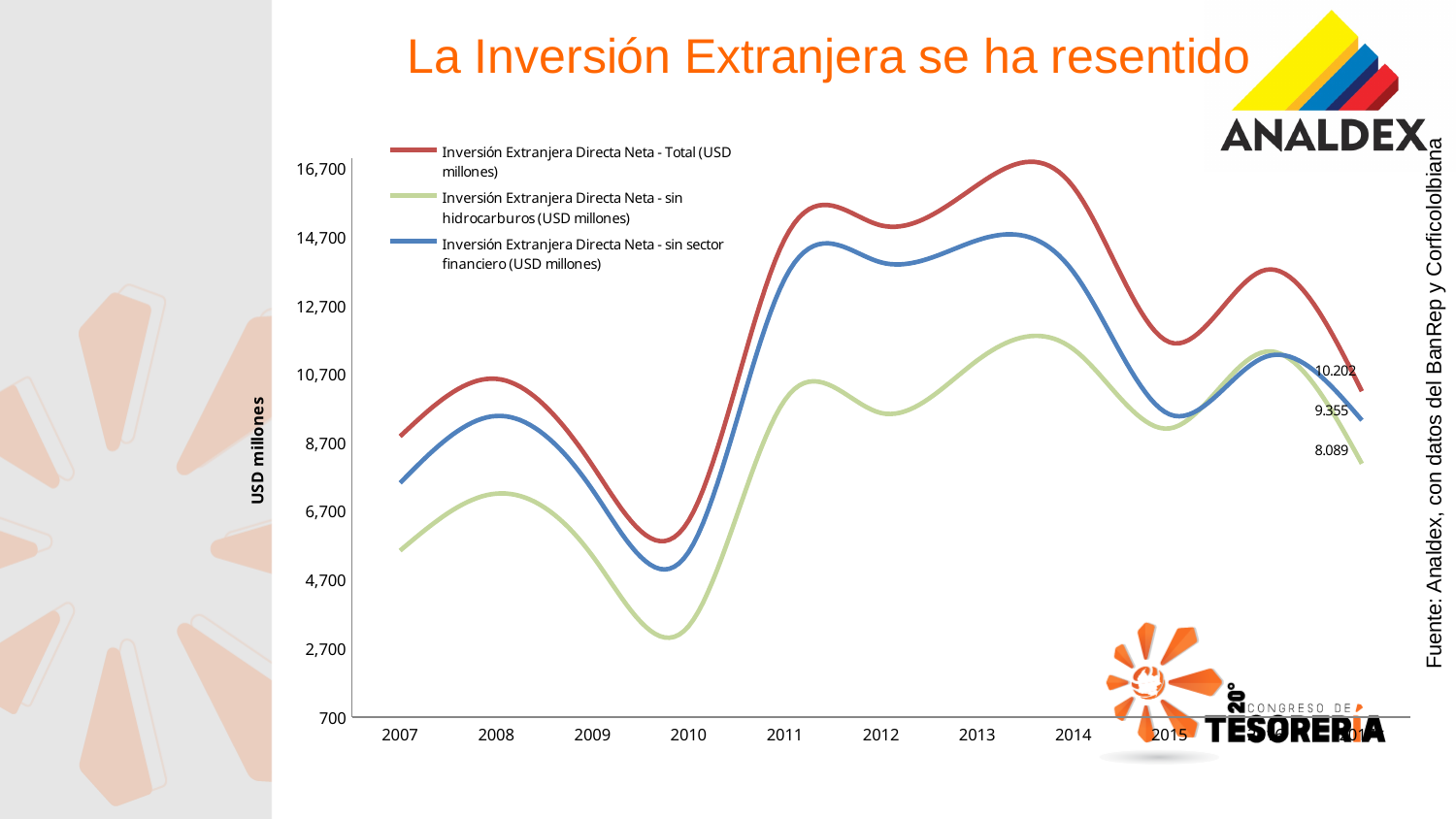
What type of chart is shown on the slide? line chart Is the value for 'sin hidrocarburos' in 2010 greater or less than 4,700? less What is the final labelled value for 'Inversión Extranjera Directa Neta - sin sector financiero (USD millones)'? 9.355 Which series has the lowest values across the whole chart? Inversión Extranjera Directa Neta - sin hidrocarburos (USD millones) What is the final labelled value for 'Inversión Extranjera Directa Neta - Total (USD millones)'? 10.202 What is the label on the vertical axis? USD millones What is the final labelled value for 'Inversión Extranjera Directa Neta - sin hidrocarburos (USD millones)'? 8.089 How many series does the legend list? 3 Does the Total series rise or fall between 2014 and 2015? fall Which series has the highest values across the whole chart? Inversión Extranjera Directa Neta - Total (USD millones) In 2013, which is larger: the Total series or the 'sin hidrocarburos' series? Total